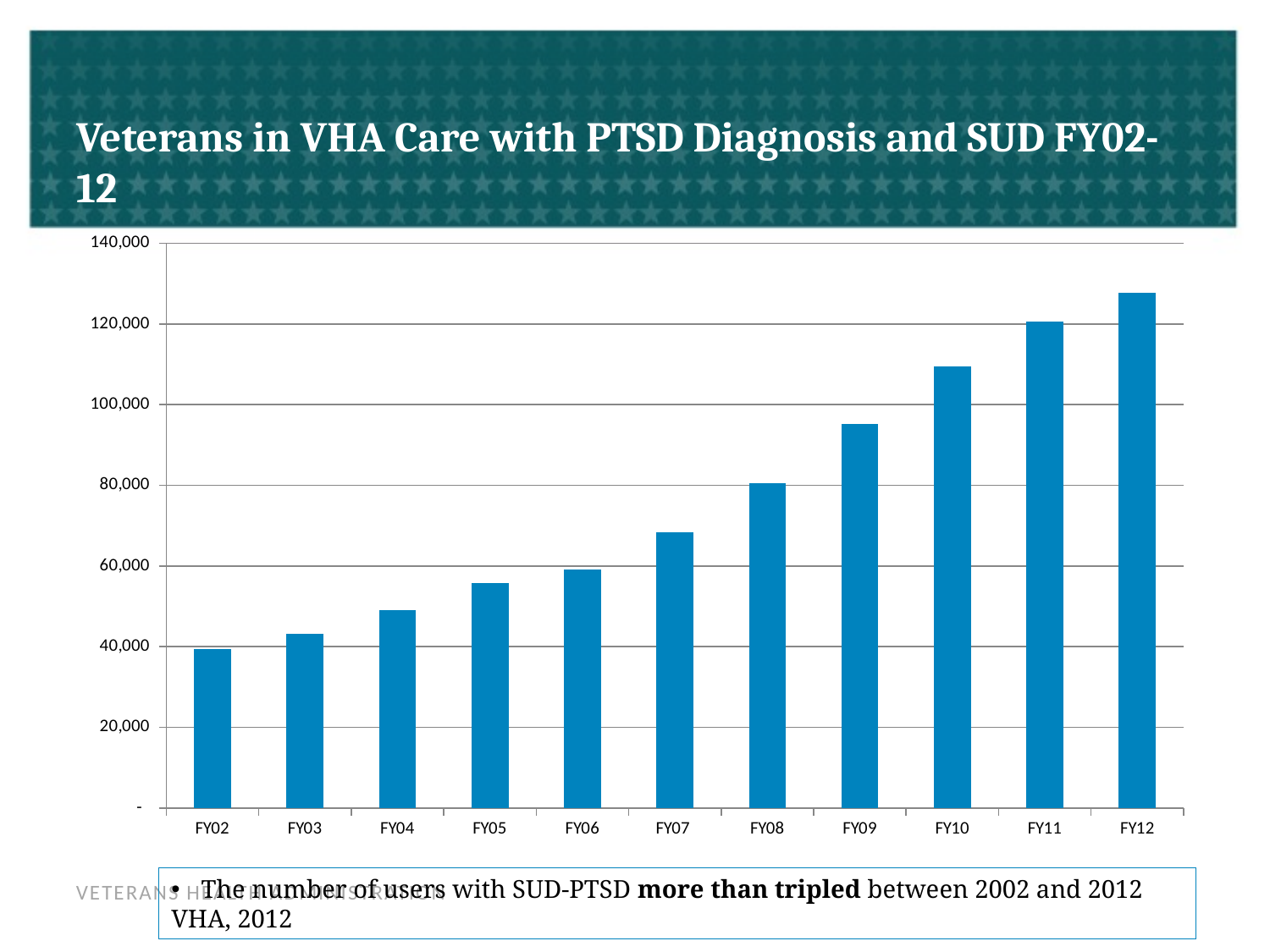
Is the value for FY09 greater or less than 100,000? less Which is larger, the value for FY10 or the value for FY05? FY10 What kind of chart is shown on the slide? Bar chart Which fiscal year has the lowest number of veterans with PTSD diagnosis and SUD? FY02 Is the value for FY04 greater or less than 60,000? less What is the title of the chart on the slide? Veterans in VHA Care with PTSD Diagnosis and SUD FY02-12 Is the value for FY07 greater or less than 60,000? greater How many fiscal years are plotted on the chart? 11 Which fiscal year has the highest number of veterans with PTSD diagnosis and SUD? FY12 Do the values rise or fall from FY02 to FY12? Rise